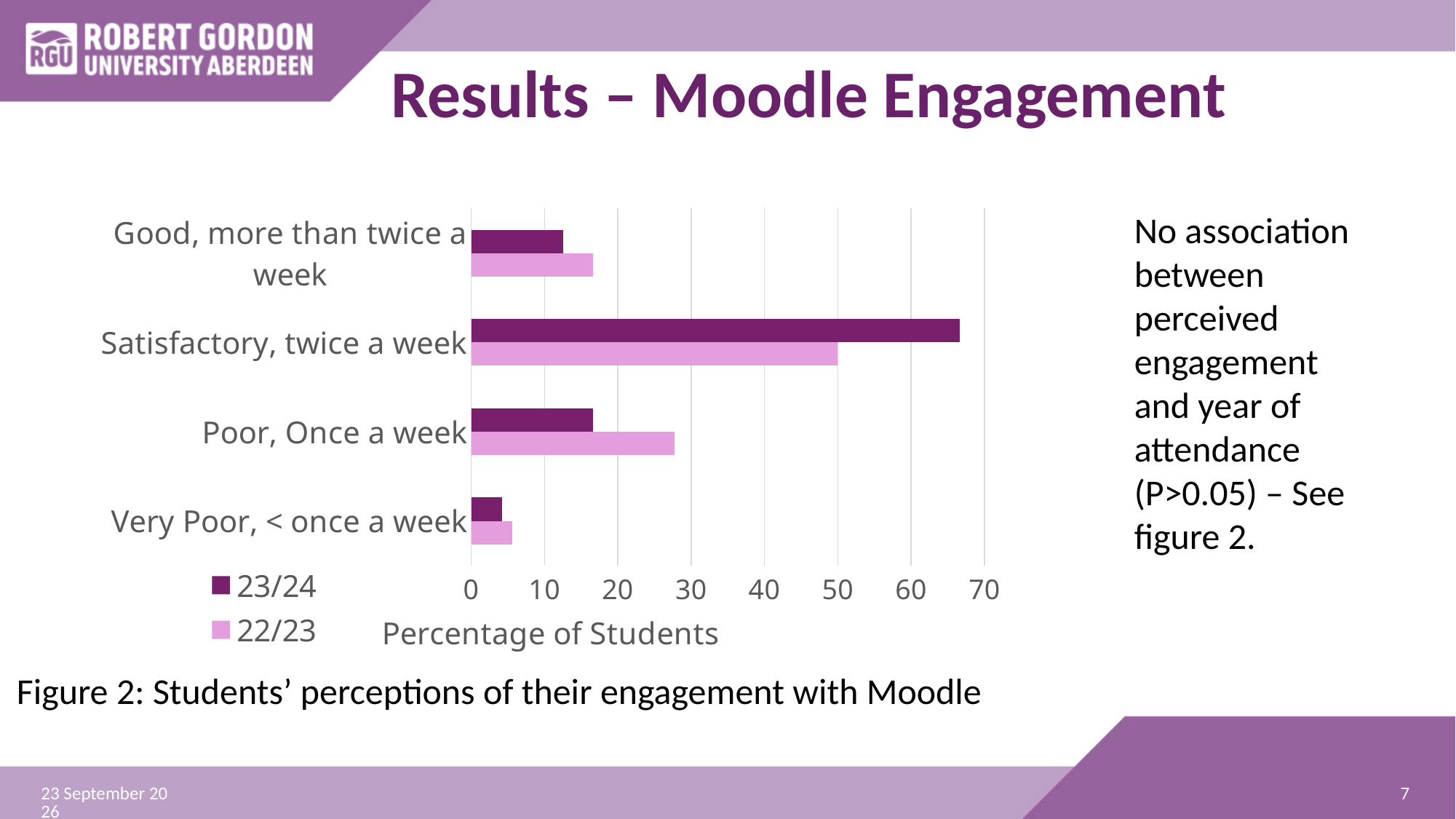
Which category has the lowest value for the 22/23 series? Very Poor, < once a week How many series does the chart's legend list? 2 Which category has the highest value for the 23/24 series? Satisfactory, twice a week For 'Poor, Once a week', which series has the larger value, 23/24 or 22/23? 22/23 Is the 22/23 value for 'Poor, Once a week' greater or less than 20? greater How many engagement categories are plotted on the chart? 4 Which category has the lowest value for the 23/24 series? Very Poor, < once a week What kind of chart is shown on the slide? Bar chart For 'Satisfactory, twice a week', which series has the larger value, 23/24 or 22/23? 23/24 Is the 23/24 value for 'Very Poor, < once a week' greater or less than 10? less What is the title of the chart's horizontal axis? Percentage of Students Is the 23/24 value for 'Satisfactory, twice a week' greater or less than 60? greater